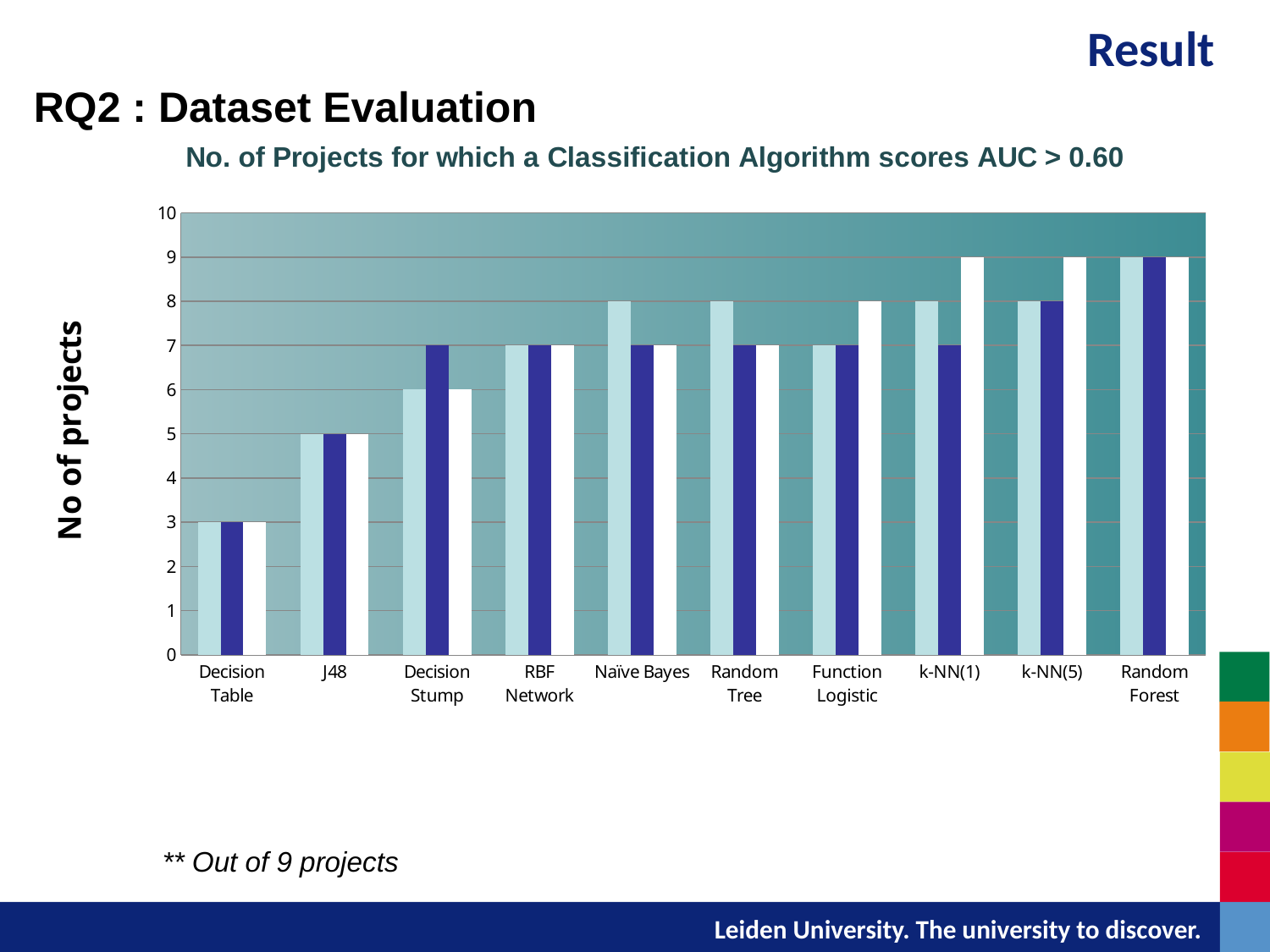
What is the value of the dark blue bar for Decision Stump? 7 What kind of chart is shown on the slide? bar chart How many bars are plotted for each classification algorithm? 3 What is the value of the light blue bar for Naïve Bayes? 8 Which classification algorithm has the lowest number of projects? Decision Table What is the value of the light blue bar for Decision Table? 3 Which classification algorithm has the highest number of projects across all three bars? Random Forest Do the values generally rise or fall moving from left to right along the x axis? rise How many classification algorithms (categories) are shown on the x axis? 10 What is the difference between the white bar for Random Forest and the white bar for J48? 4 What is the value of the white bar for k-NN(1)? 9 Which is larger: the light blue bar for Random Tree or the light blue bar for Function Logistic? Random Tree